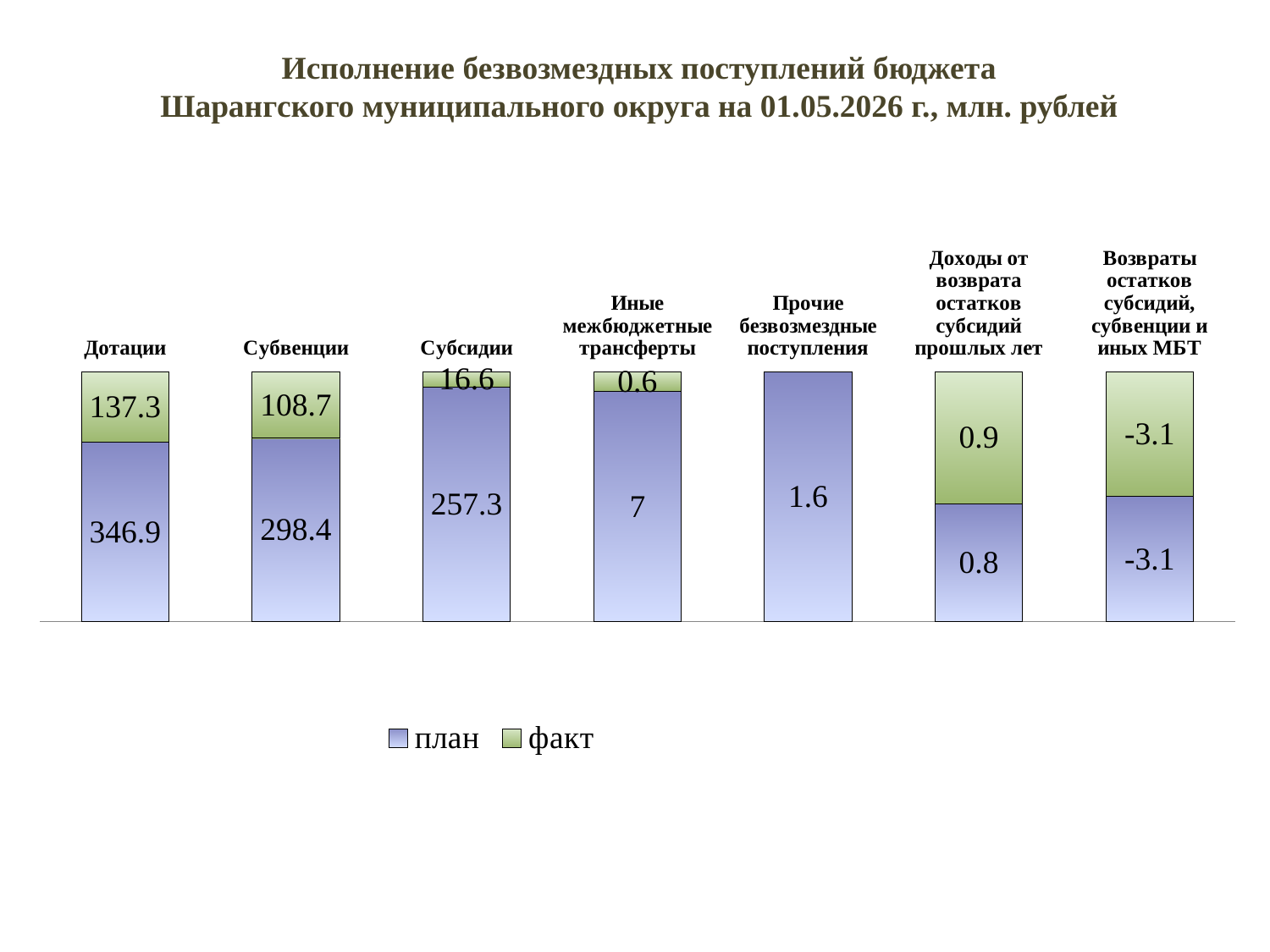
What is the факт value for Субвенции? 108.7 What is the difference between the план and факт values for Дотации? 209.6 What is the план value for Прочие безвозмездные поступления? 1.6 How many categories are shown on the chart? 7 What is the факт value for Субсидии? 16.6 What is the факт value for Возвраты остатков субсидий, субвенции и иных МБТ? -3.1 What is the план value for Иные межбюджетные трансферты? 7 What is the план value for Дотации? 346.9 What kind of chart is shown on the slide? bar chart Which category has the highest план value? Дотации How many series does the legend list? 2 For Доходы от возврата остатков субсидий прошлых лет, which is larger: план or факт? факт